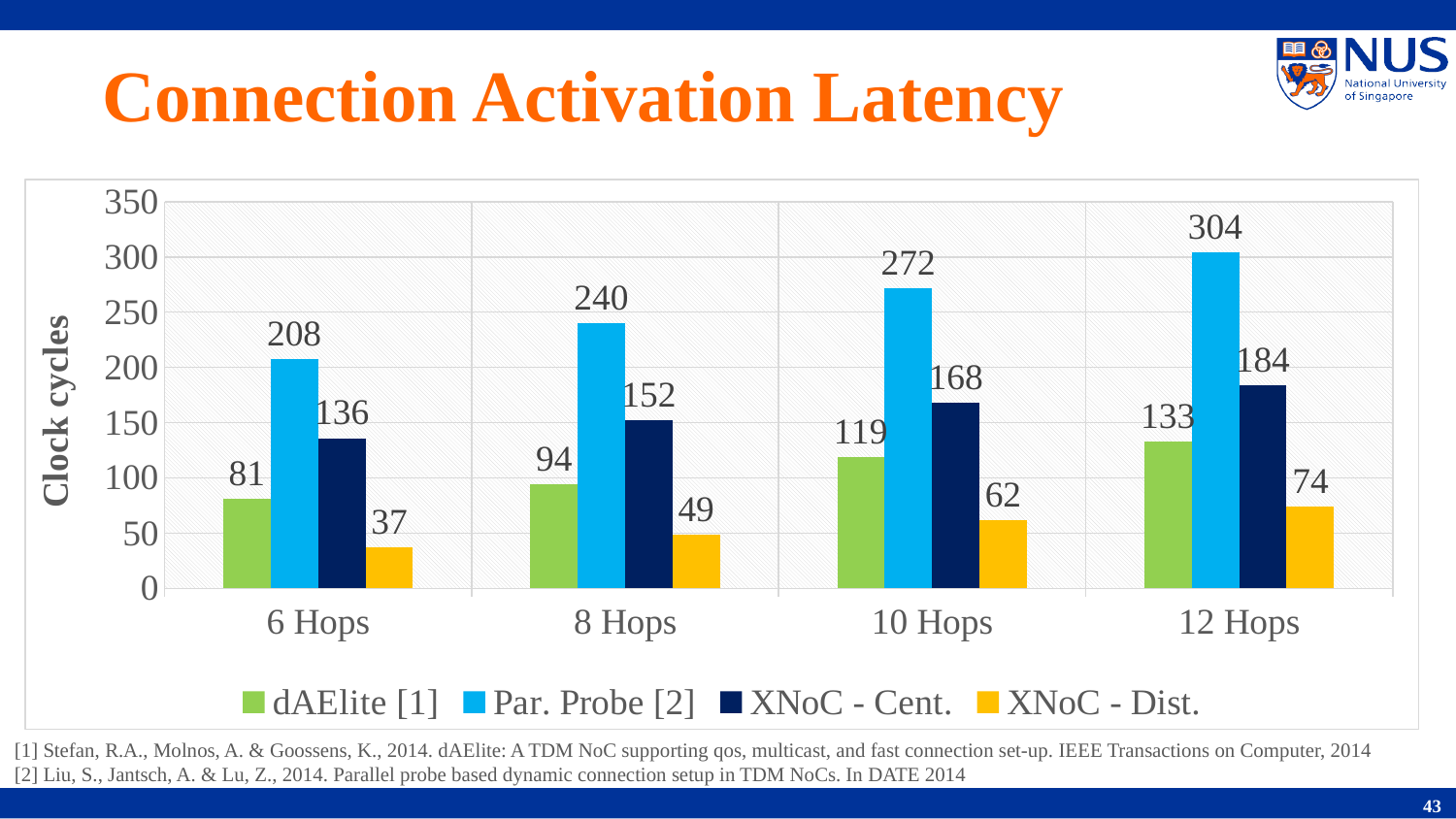
How many series does the legend list? 4 What is the value for XNoC - Dist. at 6 Hops? 37 Which is larger at 10 Hops: dAElite [1] or XNoC - Cent.? XNoC - Cent. What is the value for dAElite [1] at 12 Hops? 133 Do the XNoC - Dist. values rise or fall as the number of hops increases? Rise Which series has the lowest value at 8 Hops? XNoC - Dist. What is the value for Par. Probe [2] at 10 Hops? 272 Which series has the highest value at 12 Hops? Par. Probe [2] What is the value for XNoC - Cent. at 8 Hops? 152 What kind of chart is shown on the slide? Bar chart How many hop-count categories are shown on the x axis? 4 What is the difference between Par. Probe [2] and XNoC - Dist. at 12 Hops? 230